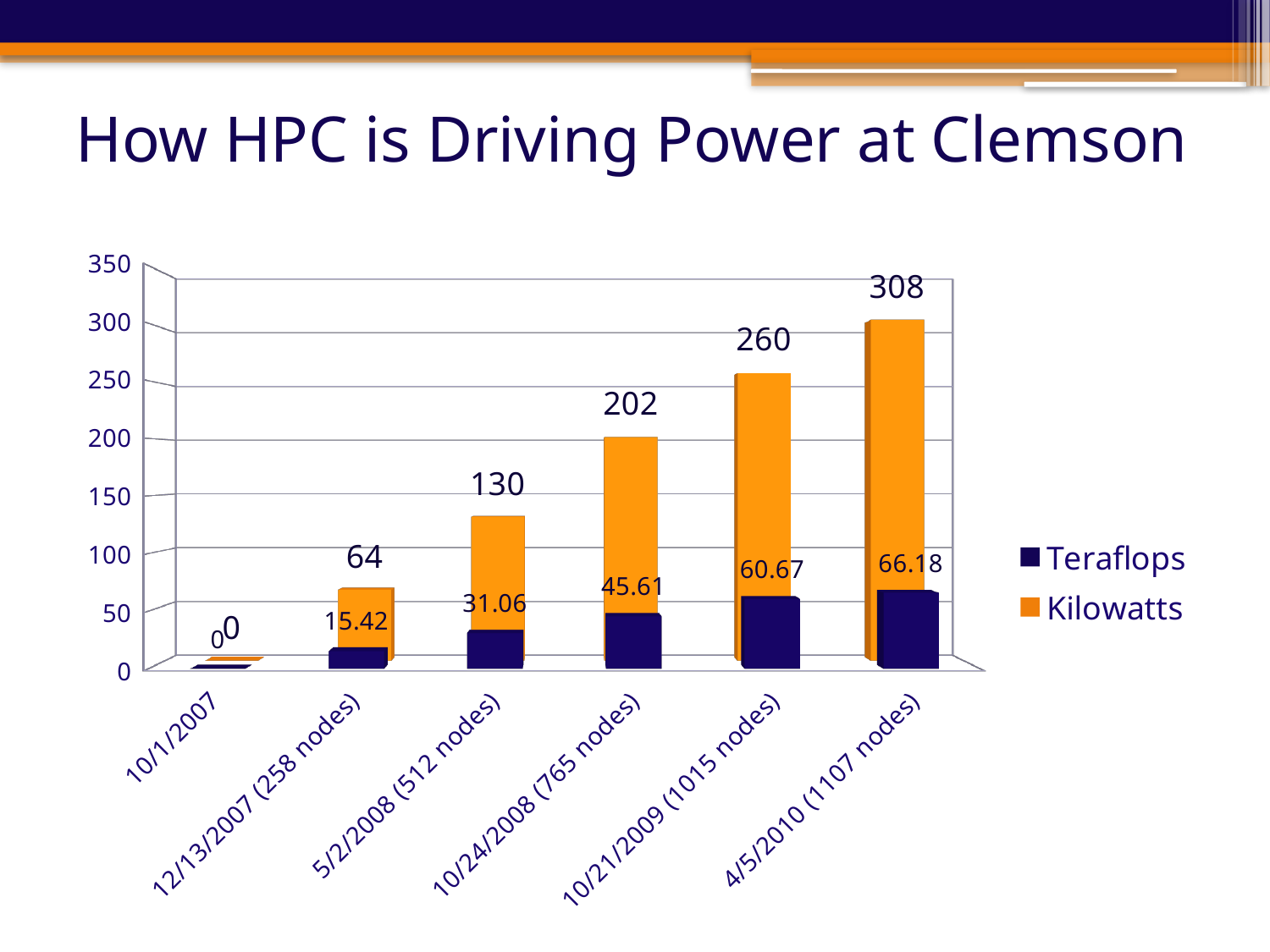
What kind of chart is shown on the slide? Bar chart What is the difference in Kilowatts between 10/21/2009 (1015 nodes) and 10/24/2008 (765 nodes)? 58 Do the Kilowatts values rise or fall from left to right along the x axis? Rise How many categories are shown on the x axis? 6 Which category has the highest Kilowatts value? 4/5/2010 (1107 nodes) What is the Kilowatts value for 4/5/2010 (1107 nodes)? 308 Which is larger: the Teraflops value for 10/21/2009 (1015 nodes) or the Teraflops value for 5/2/2008 (512 nodes)? 10/21/2009 (1015 nodes) What is the Kilowatts value for 5/2/2008 (512 nodes)? 130 Which category has the lowest Teraflops value? 10/1/2007 What is the Teraflops value for 12/13/2007 (258 nodes)? 15.42 What is the Teraflops value for 10/24/2008 (765 nodes)? 45.61 How many series does the legend list? 2